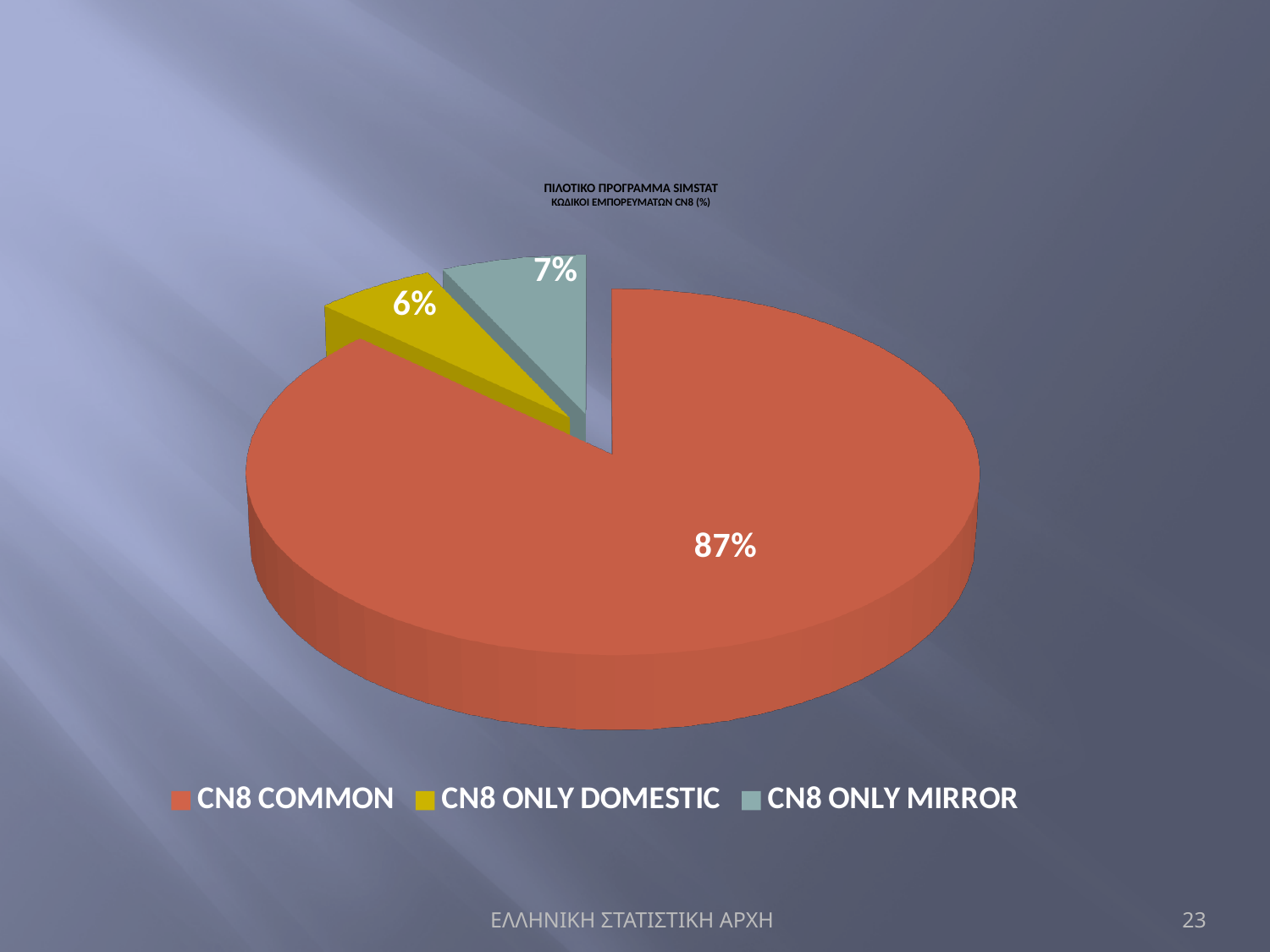
What colour is the slice for CN8 ONLY DOMESTIC? Yellow What share of the pie does CN8 COMMON represent? 87% What share of the pie does CN8 ONLY MIRROR represent? 7% What is the difference in percentage points between CN8 COMMON and CN8 ONLY MIRROR? 80 Which is larger, the slice for CN8 ONLY MIRROR or the slice for CN8 ONLY DOMESTIC? CN8 ONLY MIRROR Which category has the smallest slice of the pie? CN8 ONLY DOMESTIC How many entries does the legend list? 3 What share of the pie does CN8 ONLY DOMESTIC represent? 6% What type of chart is shown on the slide? Pie chart How many slices does the pie chart have? 3 Which category has the largest slice of the pie? CN8 COMMON What is the difference in percentage points between CN8 ONLY MIRROR and CN8 ONLY DOMESTIC? 1